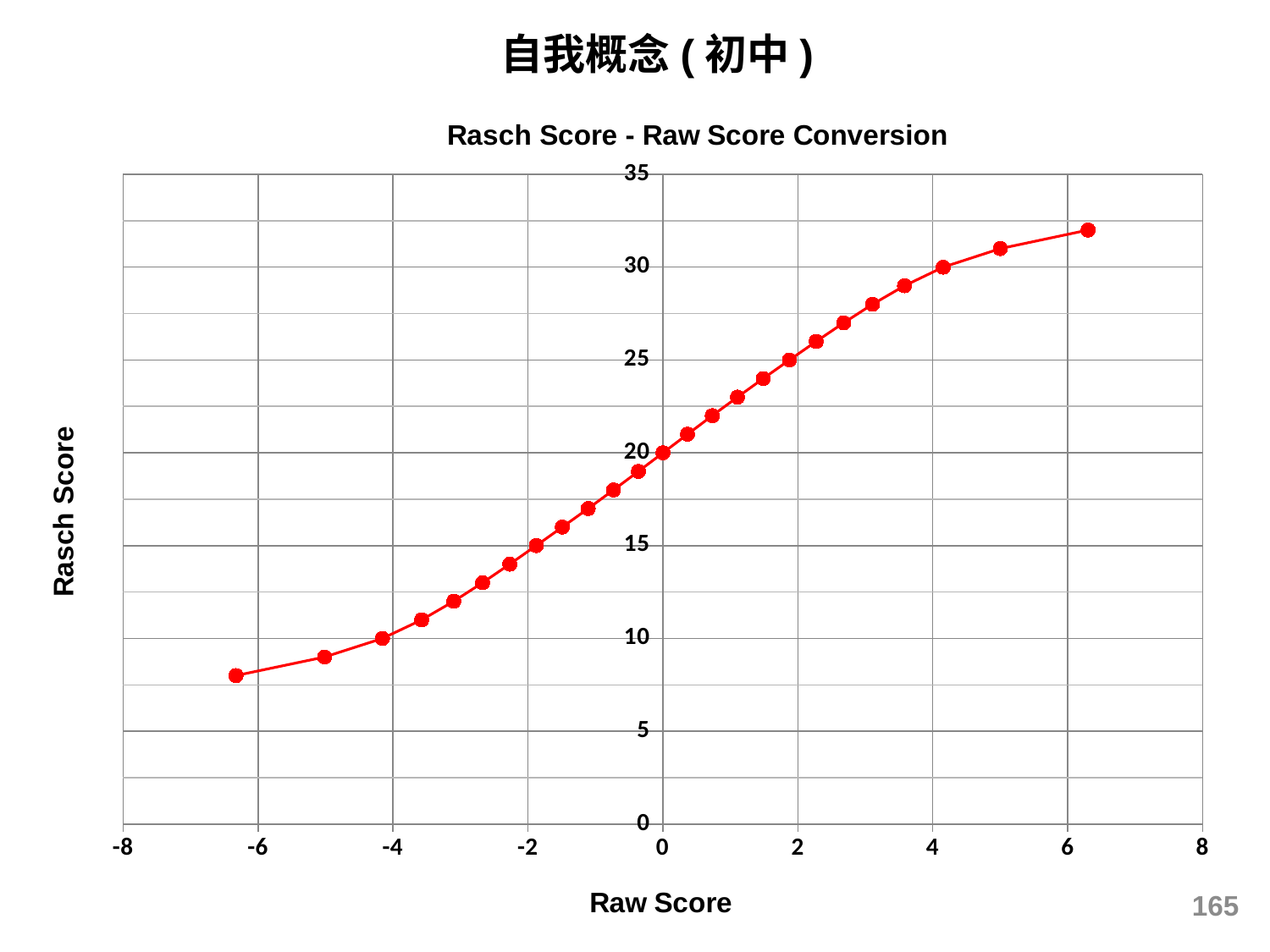
Is the lowest plotted Rasch Score greater or less than 10? less How many data points are plotted on the chart? 25 What is the title of the chart? Rasch Score - Raw Score Conversion What is the maximum value shown on the vertical axis? 35 What is the Rasch Score of the point plotted at Raw Score 0? 20 What is the label of the vertical axis? Rasch Score What kind of chart is shown on the slide? line chart Which has the larger Rasch Score: the point at Raw Score 4 or the point at Raw Score -4? the point at Raw Score 4 Do the plotted values rise or fall as Raw Score increases along the x axis? rise Is the highest plotted Rasch Score greater or less than 30? greater